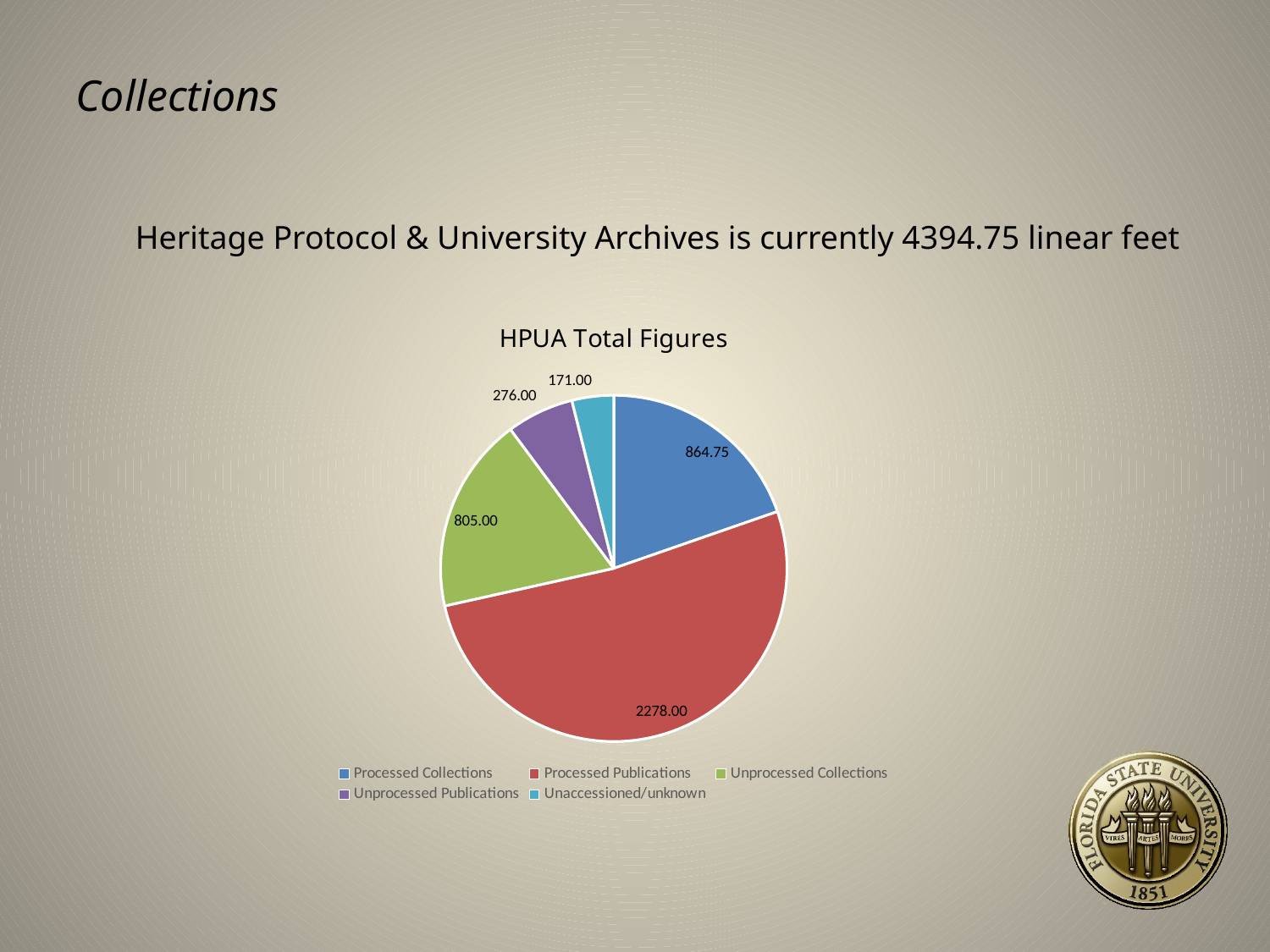
What is the value for Unaccessioned/unknown? 171.00 What is the value for Unprocessed Collections? 805.00 How many categories does the legend list? 5 Which is larger, the value for Unprocessed Publications or the value for Unaccessioned/unknown? Unprocessed Publications What colour is the slice for Unprocessed Collections? Green What is the value for Processed Publications? 2278.00 Which category has the largest slice of the pie? Processed Publications What is the title of the chart? HPUA Total Figures What is the difference between the values for Processed Publications and Processed Collections? 1413.25 Which category has the smallest slice of the pie? Unaccessioned/unknown What is the value for Processed Collections? 864.75 What type of chart is shown on the slide? Pie chart